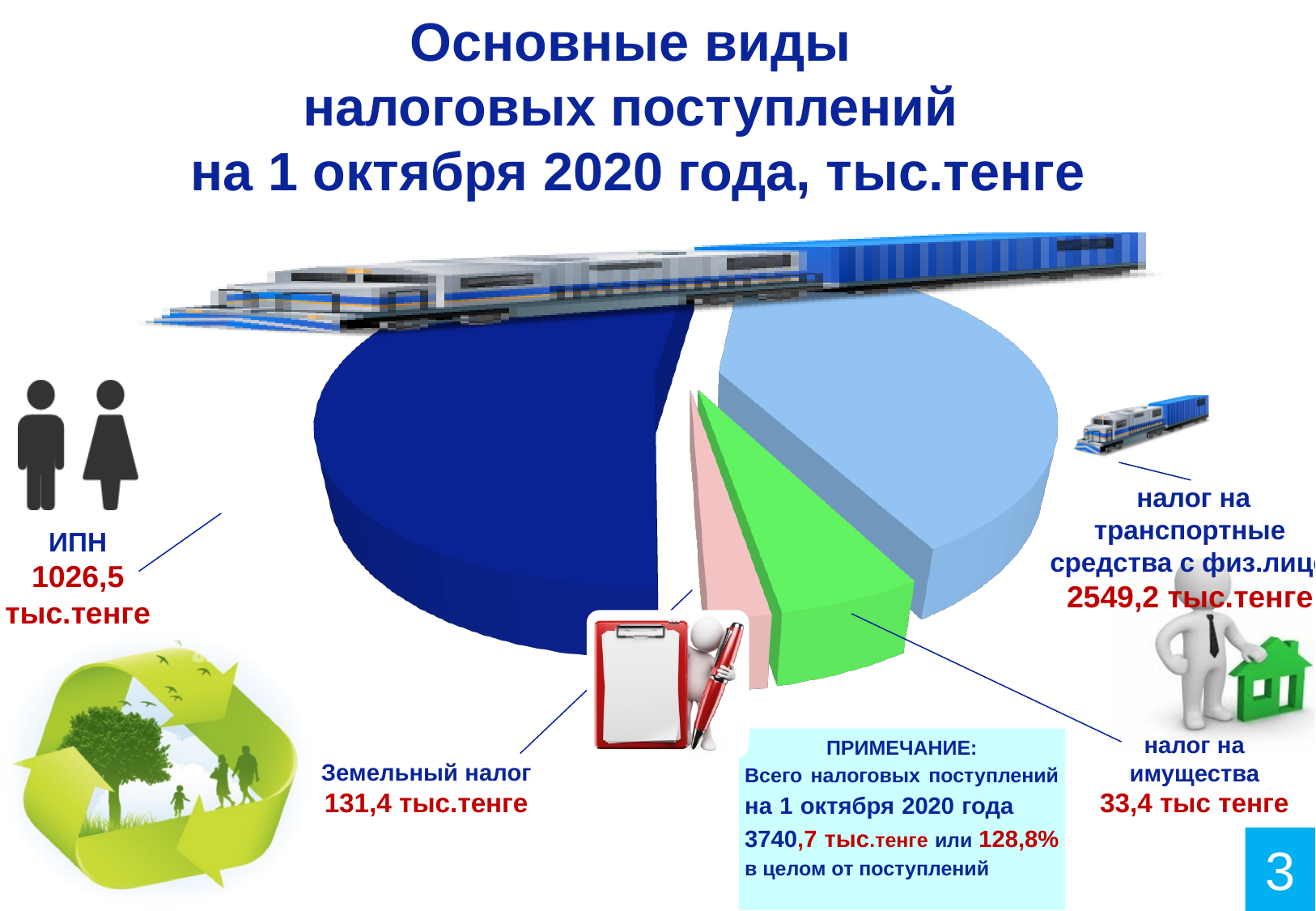
Which tax type has the highest value according to the labels? налог на транспортные средства с физ.лиц What is the value for ИПН? 1026,5 тыс.тенге How many slices does the pie chart have? 4 What is the difference between the value for налог на транспортные средства с физ.лиц and the value for ИПН? 1522,7 тыс.тенге Which tax type has the lowest value according to the labels? налог на имущества According to the note on the slide, what is the total of all tax receipts as of 1 October 2020? 3740,7 тыс.тенге Which is larger: the value for ИПН or the value for Земельный налог? ИПН What is the value for Земельный налог? 131,4 тыс.тенге What is the value for налог на имущества? 33,4 тыс тенге What is the value for налог на транспортные средства с физ.лиц? 2549,2 тыс.тенге What kind of chart is shown on the slide? pie chart What is the difference between the value for Земельный налог and the value for налог на имущества? 98,0 тыс.тенге